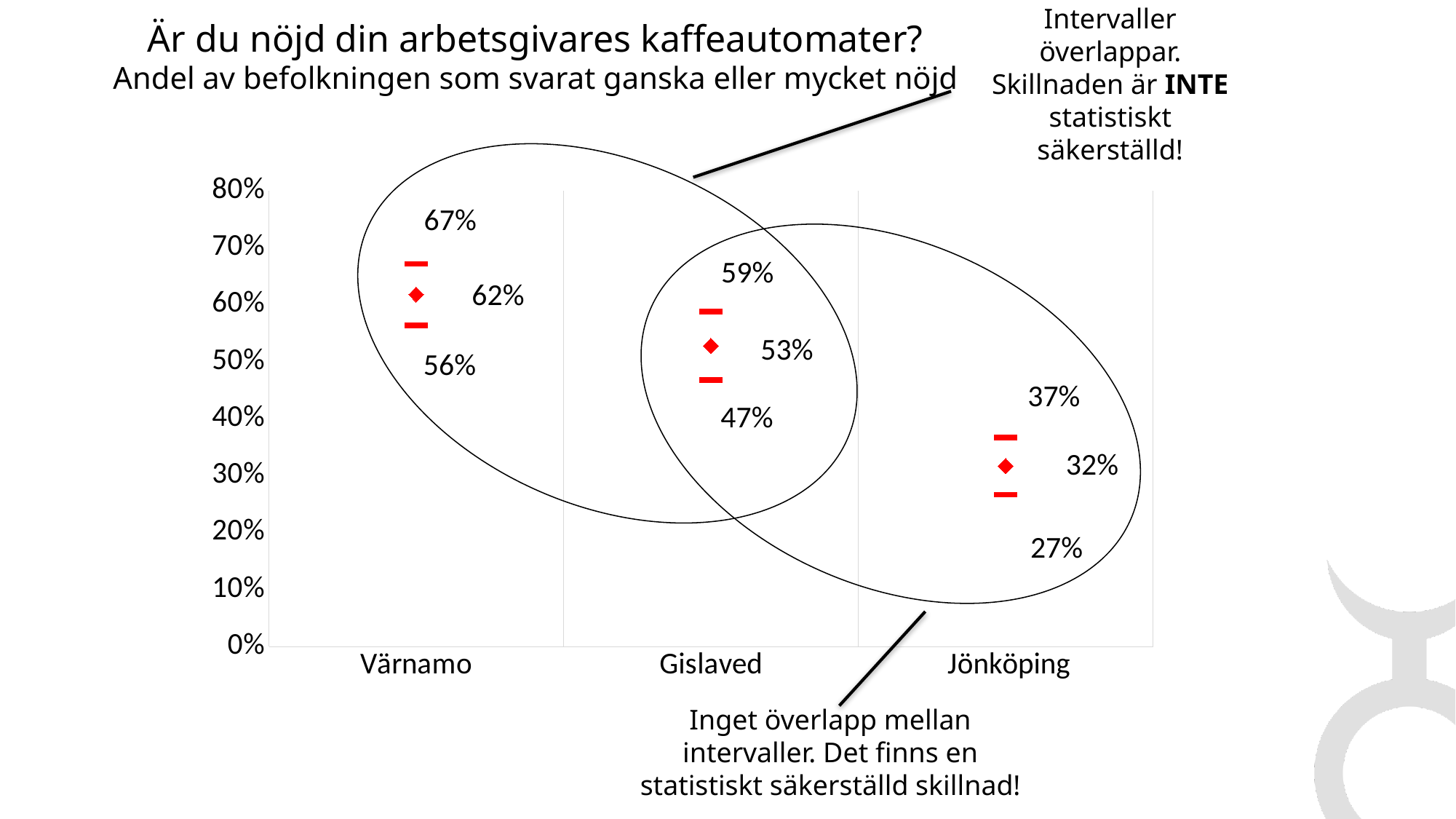
What is the point estimate (middle value) for Värnamo? 62% Which municipality has the highest point estimate? Värnamo What is the difference between the point estimates for Värnamo and Gislaved? 9 percentage points Which municipality has the lowest point estimate? Jönköping What is the difference between the upper and lower bounds of the interval for Gislaved? 12 percentage points What is the lower bound of the interval shown for Jönköping? 27% How many municipalities are shown on the x axis? 3 Which is larger, the point estimate for Gislaved or for Jönköping? Gislaved What is the point estimate (middle value) for Jönköping? 32% What is the point estimate (middle value) for Gislaved? 53% What is the upper bound of the interval shown for Värnamo? 67% Do the point estimates rise or fall from left to right along the x axis? fall